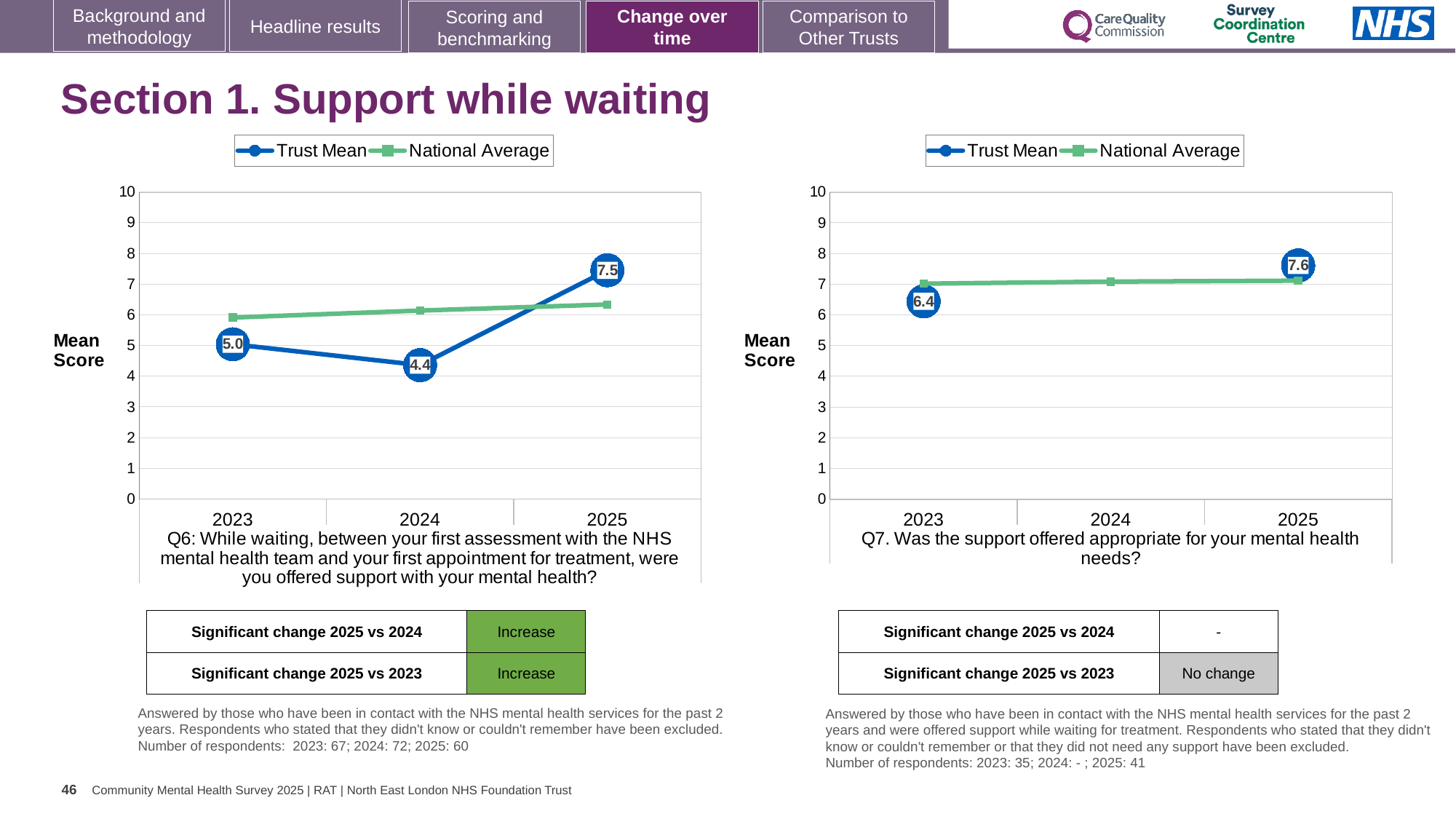
In the Q6 chart on the left, which year has the lowest Trust Mean score? 2024 In the Q6 chart on the left, what is the Trust Mean score for 2023? 5.0 In the Q7 chart on the right, what is the Trust Mean score for 2025? 7.6 In the Q6 chart on the left, what is the Trust Mean score for 2024? 4.4 In the Q6 chart on the left, which year has the highest Trust Mean score? 2025 In the Q7 chart on the right, what is the Trust Mean score for 2023? 6.4 How many series does the legend of the Q7 chart on the right list? 2 In the Q6 chart on the left, what is the difference between the Trust Mean scores for 2025 and 2024? 3.1 In the Q6 chart on the left, is the National Average for 2023 greater or less than 5? greater In the Q7 chart on the right, is the Trust Mean for 2025 higher or lower than the National Average for 2025? higher In the Q6 chart on the left, what is the Trust Mean score for 2025? 7.5 What type of chart is the Q6 chart on the left? Line chart